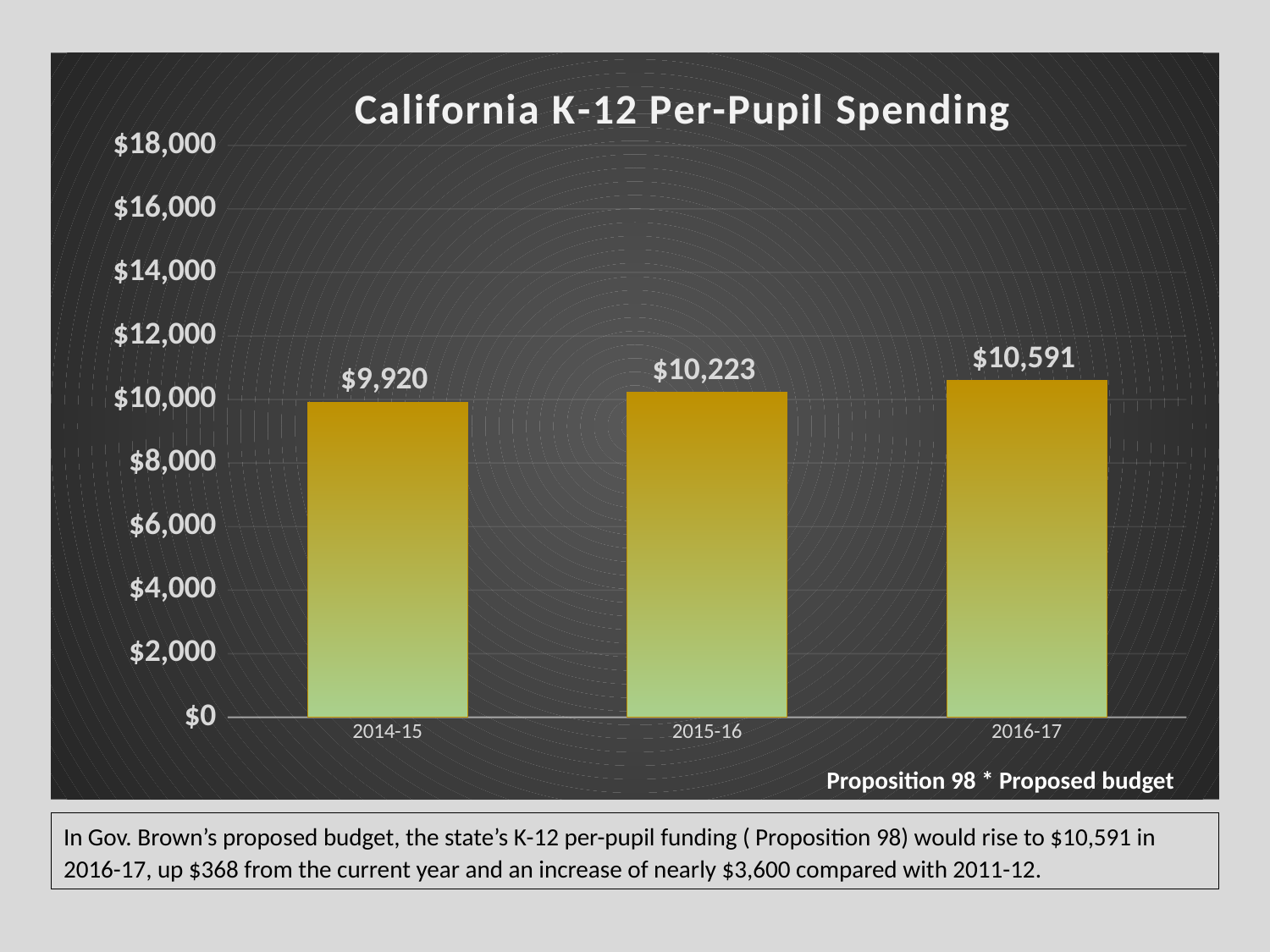
How many years are shown on the chart? 3 Is the value for 2014-15 greater or less than $10,000? less What is the difference between the 2016-17 and 2015-16 values? $368 What is the per-pupil spending value for 2014-15? $9,920 Do the values rise or fall from 2014-15 to 2016-17? rise What is the difference between the 2016-17 and 2014-15 values? $671 Which year has the highest per-pupil spending? 2016-17 What is the per-pupil spending value for 2015-16? $10,223 Which is larger, the value for 2014-15 or the value for 2015-16? 2015-16 Which year has the lowest per-pupil spending? 2014-15 What is the per-pupil spending value for 2016-17? $10,591 What kind of chart is shown on the slide? bar chart